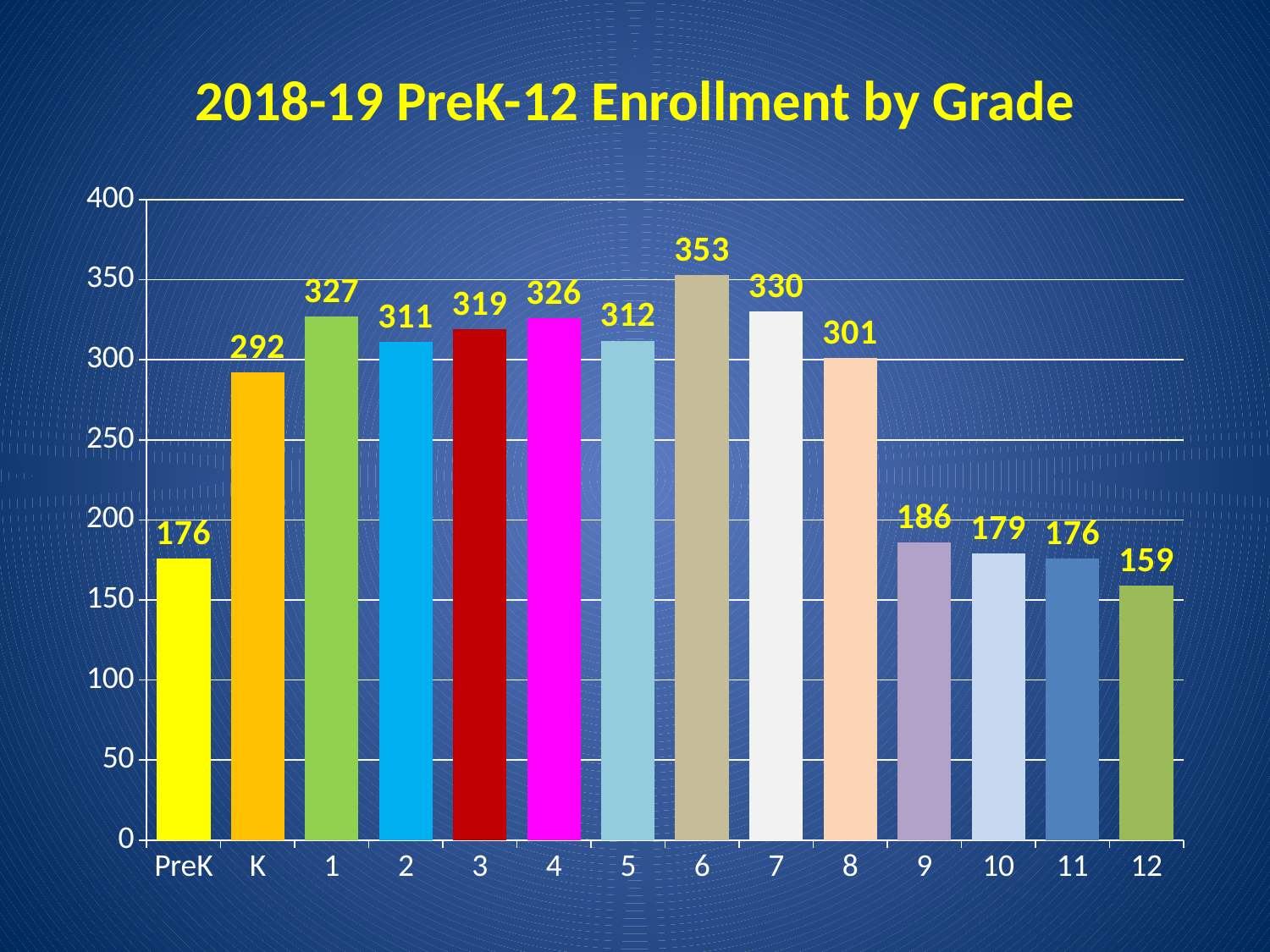
Which has higher enrollment, grade 1 or grade 4? Grade 1 Which grade has the lowest enrollment? 12 What is the difference in enrollment between grade 8 and grade 9? 115 Which grade has the highest enrollment? 6 What is the enrollment for grade 6? 353 How many grade categories are shown on the x axis? 14 What is the enrollment for Kindergarten (K)? 292 What is the enrollment for grade 12? 159 What kind of chart is shown on the slide? Bar chart What is the title of the chart? 2018-19 PreK-12 Enrollment by Grade Is the enrollment for grade 10 greater or less than 200? less Do enrollment values rise or fall from grade 9 to grade 12? Fall